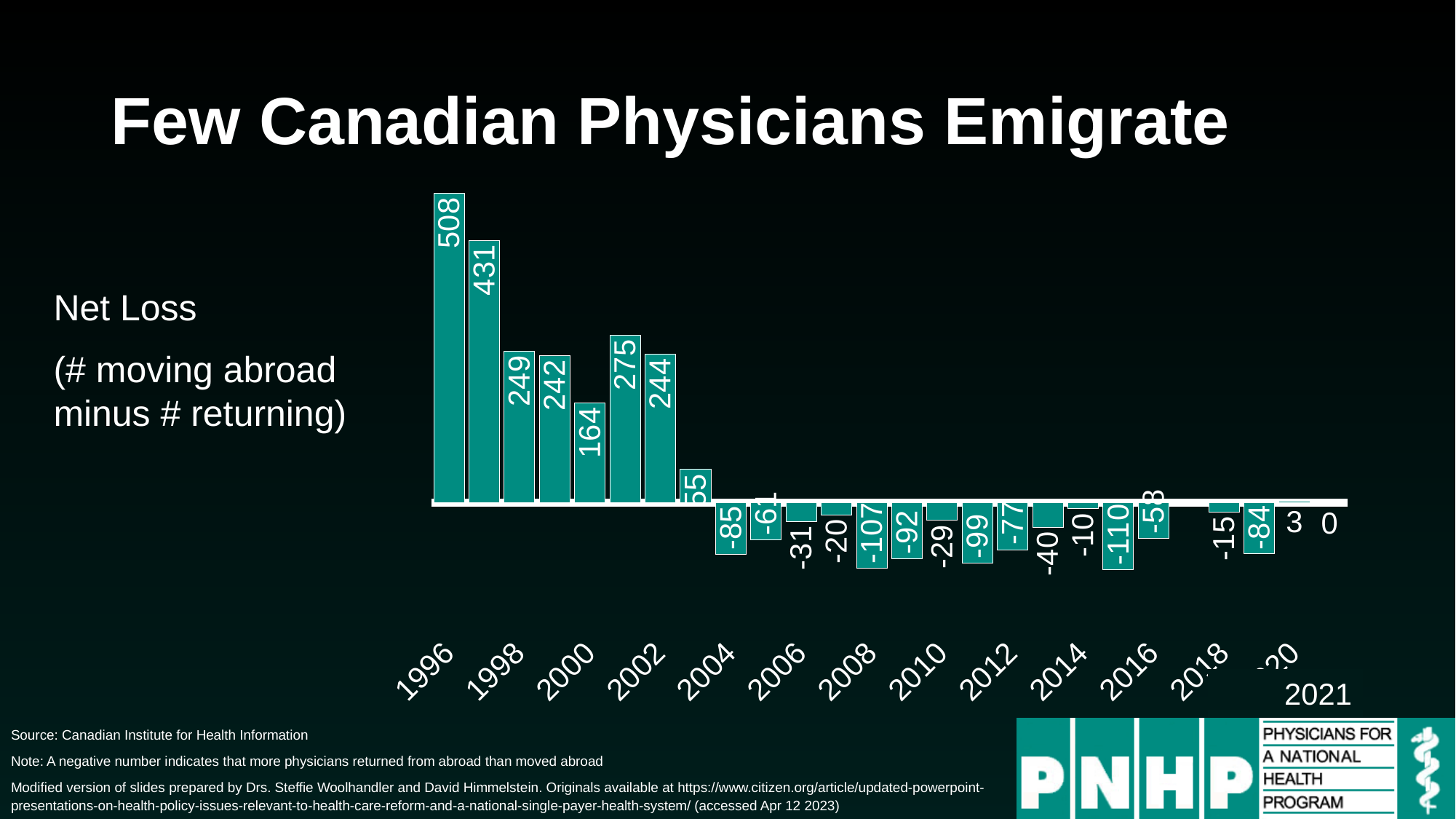
Do the values generally rise or fall from 1996 to 2021? Fall Which year has the larger value, 2004 or 2014? 2014 What is the net loss value for 2000? 164 What is the lowest value shown on the chart? -110 What is the net loss value for 1996? 508 What is the net loss value for 2008? -107 Which year has the highest net loss value? 1996 What is the title of the slide? Few Canadian Physicians Emigrate What is the net loss value for 2021? 0 What is the difference between the values for 1996 and 1998? 259 Which year has the larger value, 2000 or 2002? 2002 What kind of chart is shown on the slide? Bar chart